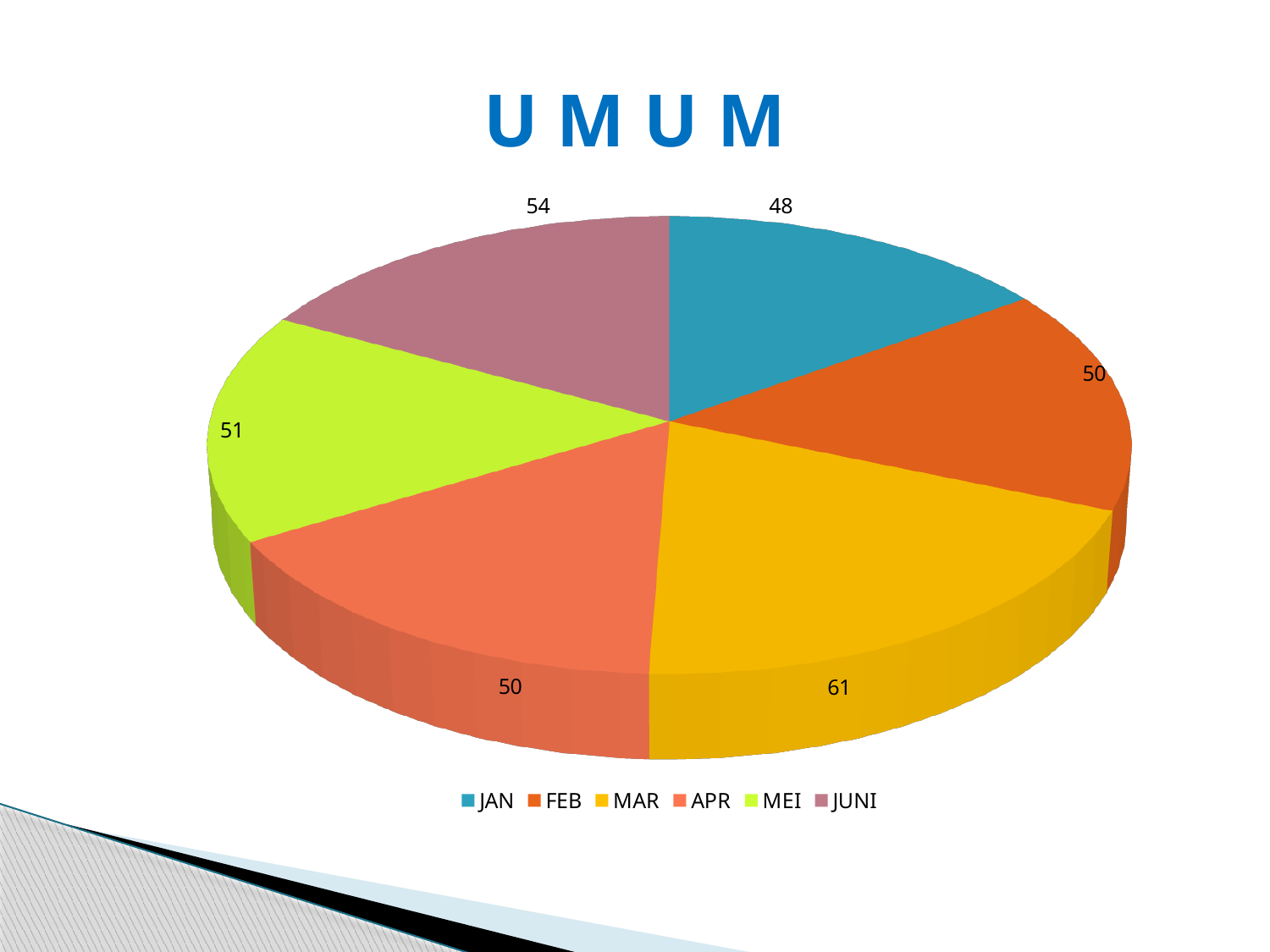
What is the difference between the values for MAR and JAN? 13 Which is larger, the value for JUNI or the value for MEI? JUNI Which two categories have the same value of 50? FEB and APR Which category has the largest slice? MAR How many categories does the pie chart have? 6 Which category has the smallest slice? JAN What is the value for JAN? 48 What is the value for MAR? 61 What is the value for JUNI? 54 What is the title of the chart? UMUM What kind of chart is shown on the slide? pie chart What is the value for MEI? 51